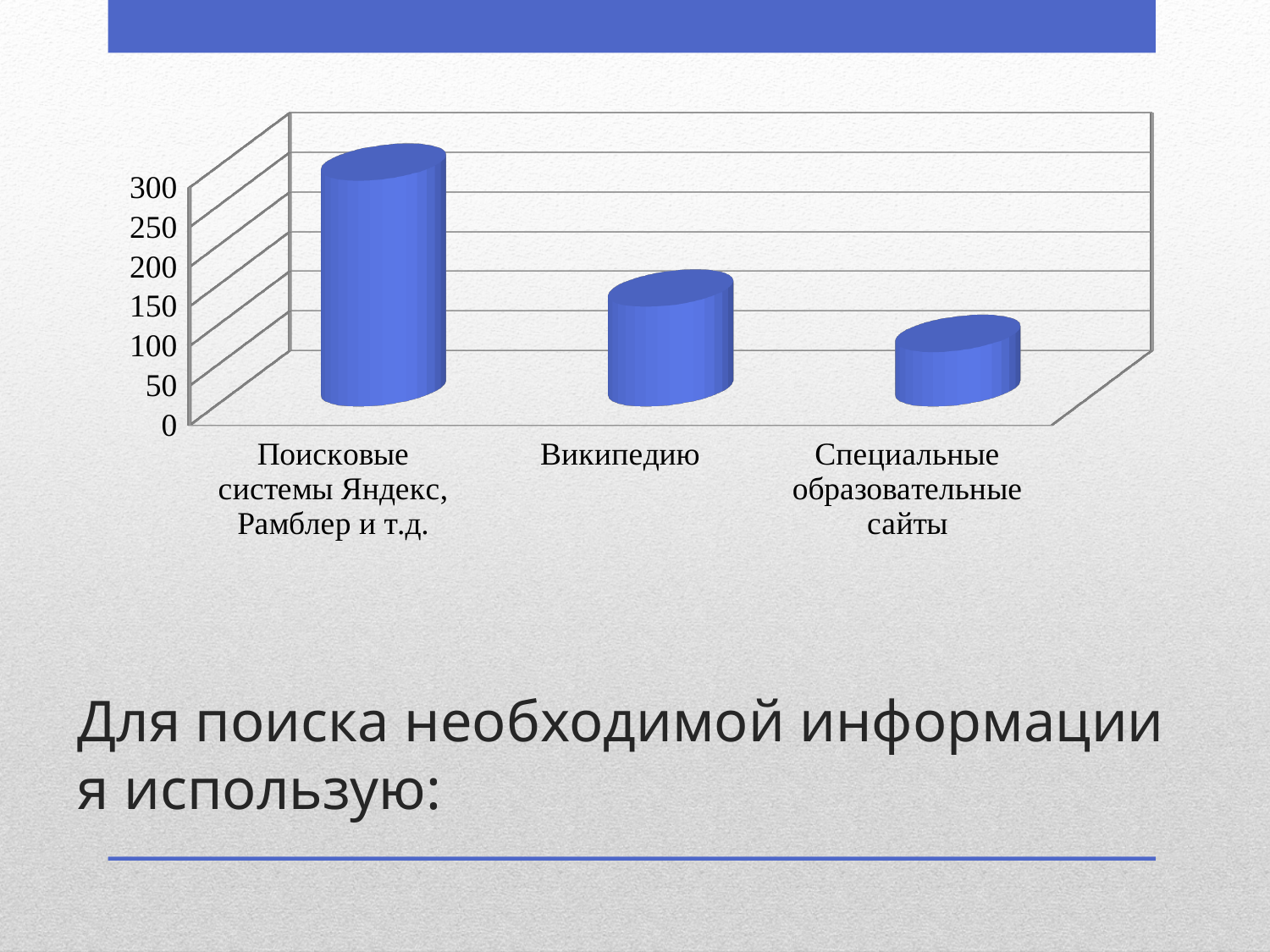
Which category has the lowest bar? Специальные образовательные сайты Which is larger, the value for Википедию or the value for Специальные образовательные сайты? Википедию Do the bar values rise or fall from left to right along the x axis? fall How many categories are shown on the x axis of the chart? 3 What is the highest value labelled on the vertical axis of the chart? 300 Is the value for Википедию greater or less than 100? greater Is the value for Специальные образовательные сайты greater or less than 150? less Which category has the highest bar? Поисковые системы Яндекс, Рамблер и т.д. Which is larger, the value for Поисковые системы Яндекс, Рамблер и т.д. or the value for Википедию? Поисковые системы Яндекс, Рамблер и т.д. Is the value for Поисковые системы Яндекс, Рамблер и т.д. greater or less than 250? greater What kind of chart is shown on the slide? bar chart